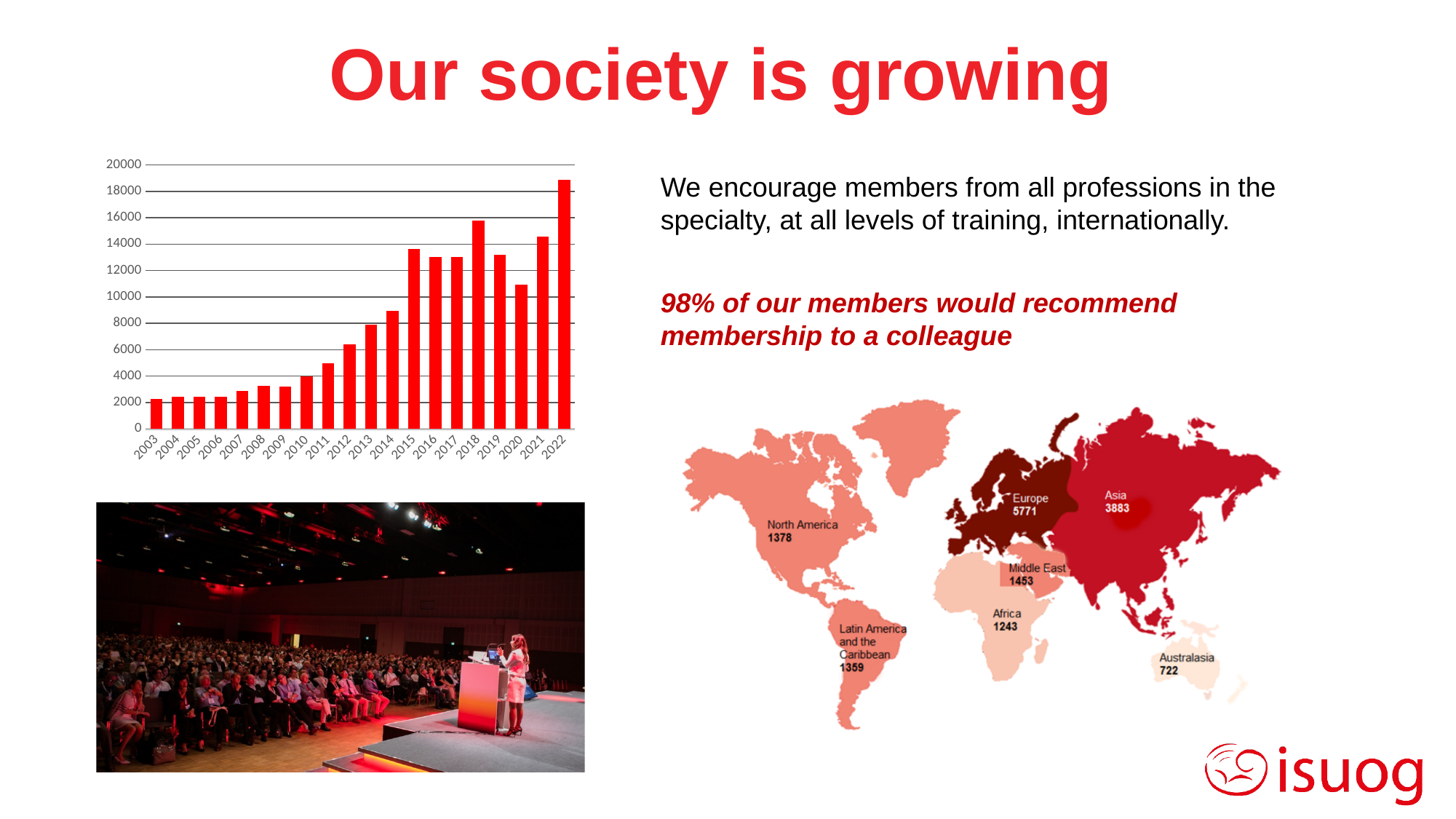
On the world map on the right, what is the value shown for Europe? 5771 On the world map on the right, how many regions have a value labelled? 7 In the bar chart on the left, is the value for 2011 greater or less than 6000? less In the bar chart on the left, which year has the larger value, 2018 or 2019? 2018 What kind of chart is shown on the left side of the slide, below the title? bar chart In the bar chart on the left, is the value for 2022 greater or less than 18000? greater In the bar chart on the left, is the value for 2018 greater or less than 14000? greater In the bar chart on the left, how many years are shown on the x axis? 20 In the bar chart on the left, do the values generally rise or fall from 2003 to 2022? rise In the bar chart on the left, which year has the highest bar? 2022 On the world map on the right, what is the difference between the values for Europe and Asia? 1888 On the world map on the right, which region has the lowest value? Australasia